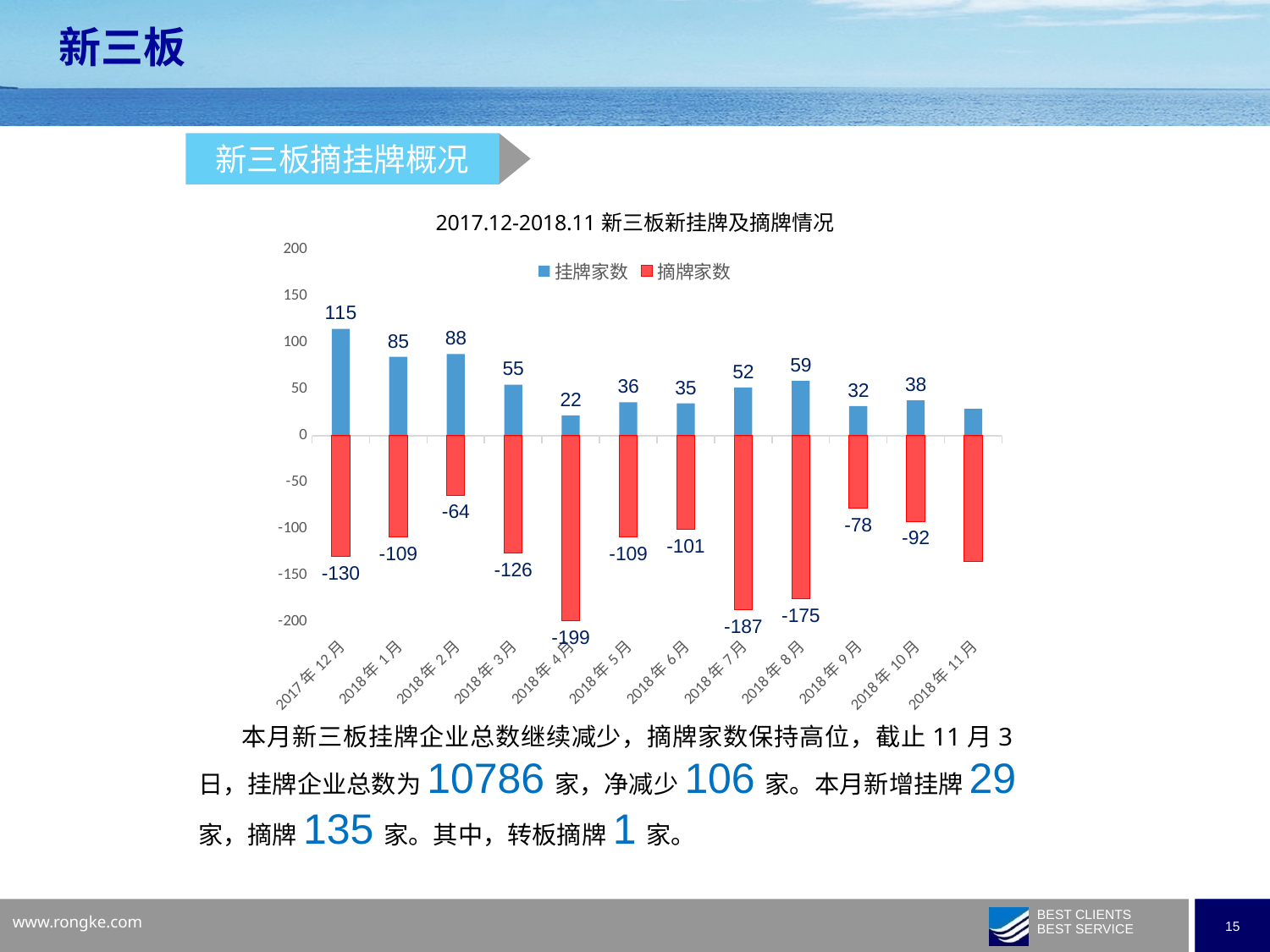
What is the difference between 挂牌家数 for 2018年1月 and 2018年3月? 30 Which month has the lowest 挂牌家数 among the labelled values? 2018年4月 What is the value of 挂牌家数 for 2017年12月? 115 How many series does the legend list? 2 What is the value of 摘牌家数 for 2018年4月? -199 Is the value of 挂牌家数 for 2018年11月 greater or less than 50? less What type of chart is shown? Bar chart What is the value of 摘牌家数 for 2018年2月? -64 Which month has the highest 挂牌家数? 2017年12月 What is the value of 挂牌家数 for 2018年8月? 59 How many months are shown on the x axis? 12 Which is larger in magnitude, 摘牌家数 for 2018年7月 or 2018年8月? 2018年7月